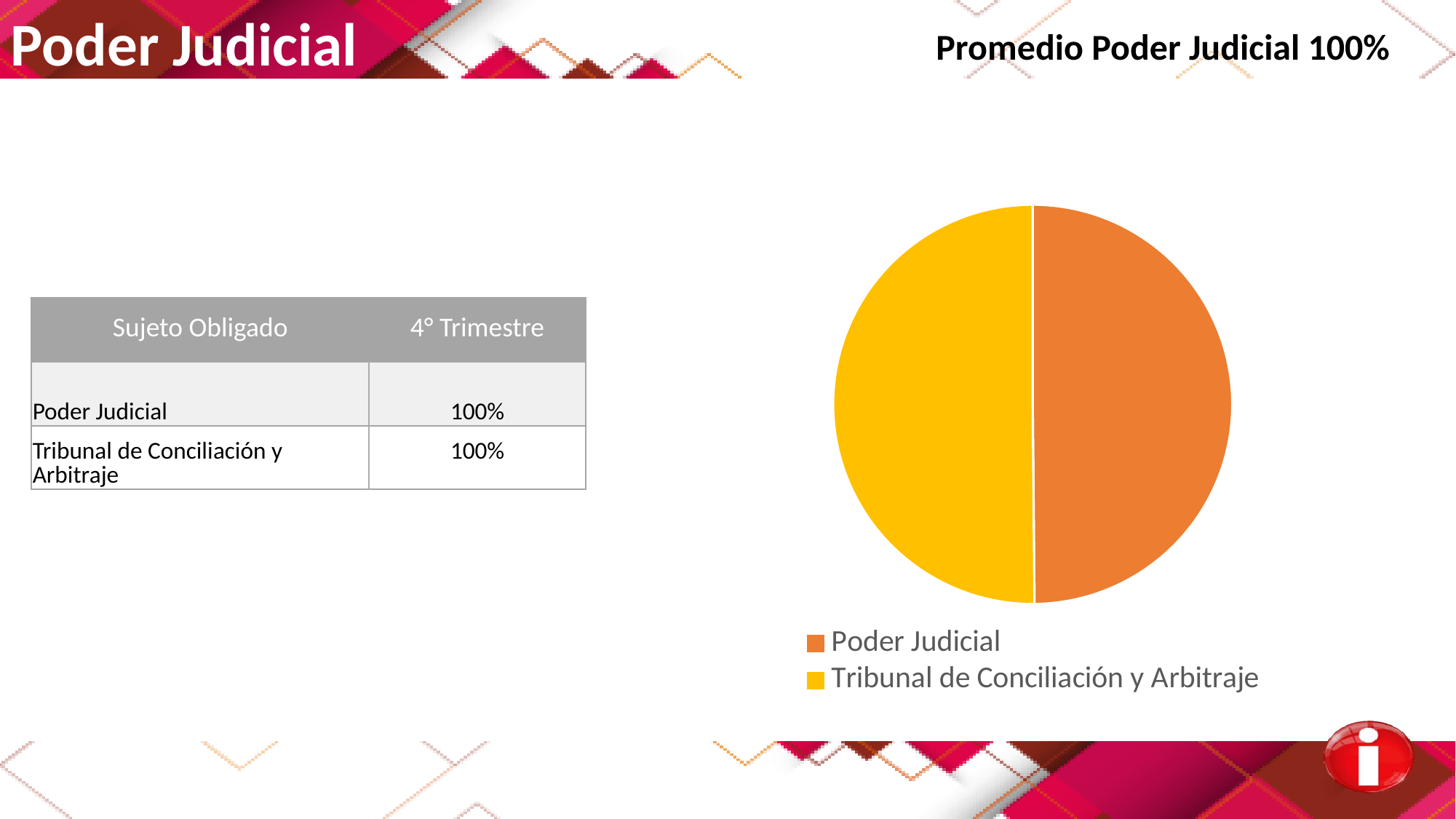
According to the table, what is the 4° Trimestre value for Poder Judicial? 100% What kind of chart is shown on the slide? pie chart How many slices does the pie chart have? 2 What is the difference between the 4° Trimestre values of Poder Judicial and Tribunal de Conciliación y Arbitraje shown in the table? 0% What is the Promedio Poder Judicial stated at the top of the slide? 100% Which legend entry is shown in orange in the pie chart? Poder Judicial Which legend entry is shown in yellow in the pie chart? Tribunal de Conciliación y Arbitraje How many entries does the legend of the pie chart list? 2 According to the table, what is the 4° Trimestre value for Tribunal de Conciliación y Arbitraje? 100%